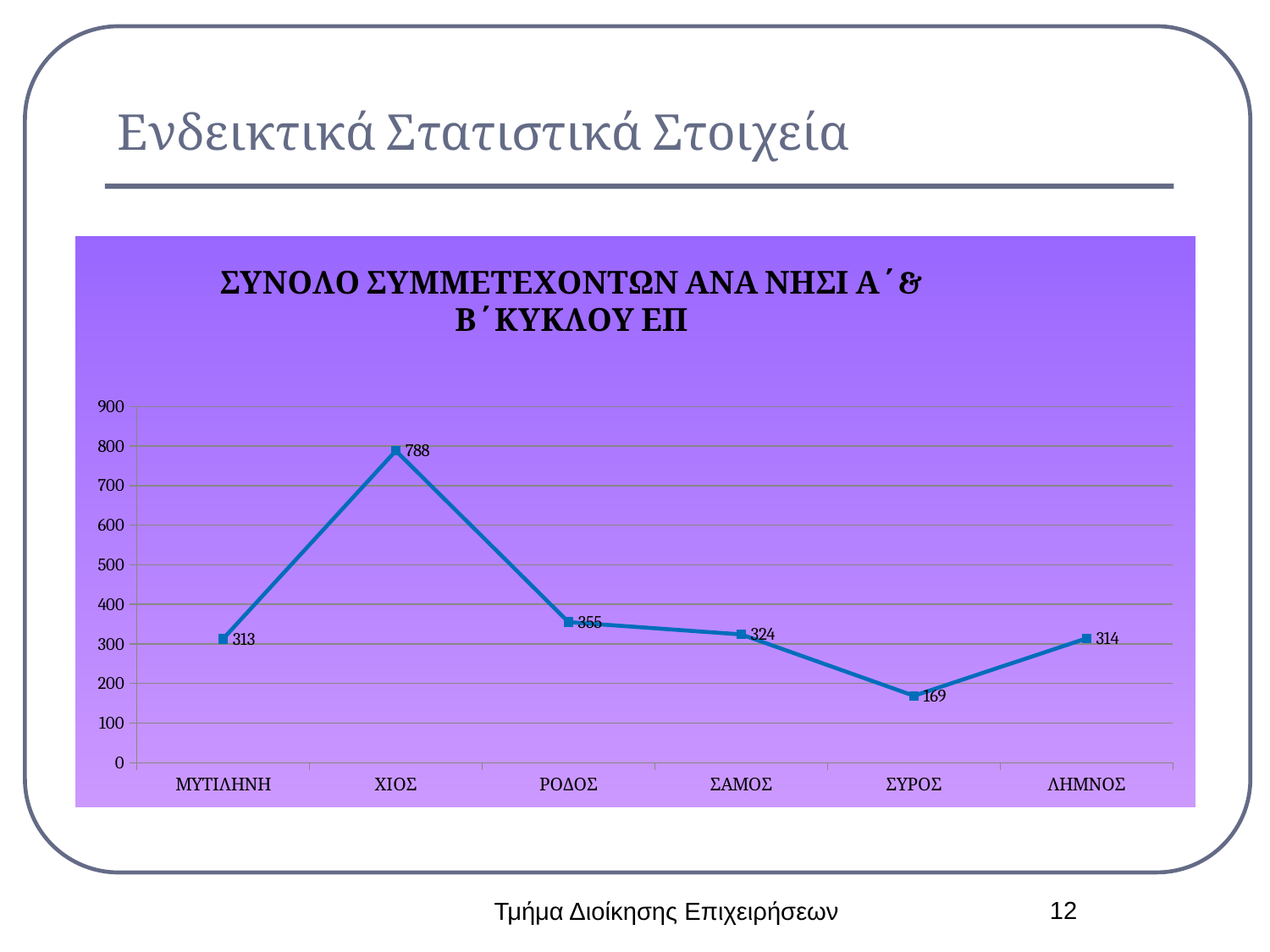
What is the difference between the values for ΧΙΟΣ and ΡΟΔΟΣ? 433 Which is larger, the value for ΡΟΔΟΣ or the value for ΣΑΜΟΣ? ΡΟΔΟΣ Which island has the lowest value? ΣΥΡΟΣ What is the title of the chart? ΣΥΝΟΛΟ ΣΥΜΜΕΤΕΧΟΝΤΩΝ ΑΝΑ ΝΗΣΙ Α΄& Β΄ΚΥΚΛΟΥ ΕΠ What is the value for ΜΥΤΙΛΗΝΗ? 313 Which island has the highest value? ΧΙΟΣ What kind of chart is this? line chart How many islands are shown on the x axis? 6 What is the value for ΧΙΟΣ? 788 What is the value for ΣΥΡΟΣ? 169 What is the difference between the values for ΣΑΜΟΣ and ΣΥΡΟΣ? 155 What is the value for ΛΗΜΝΟΣ? 314